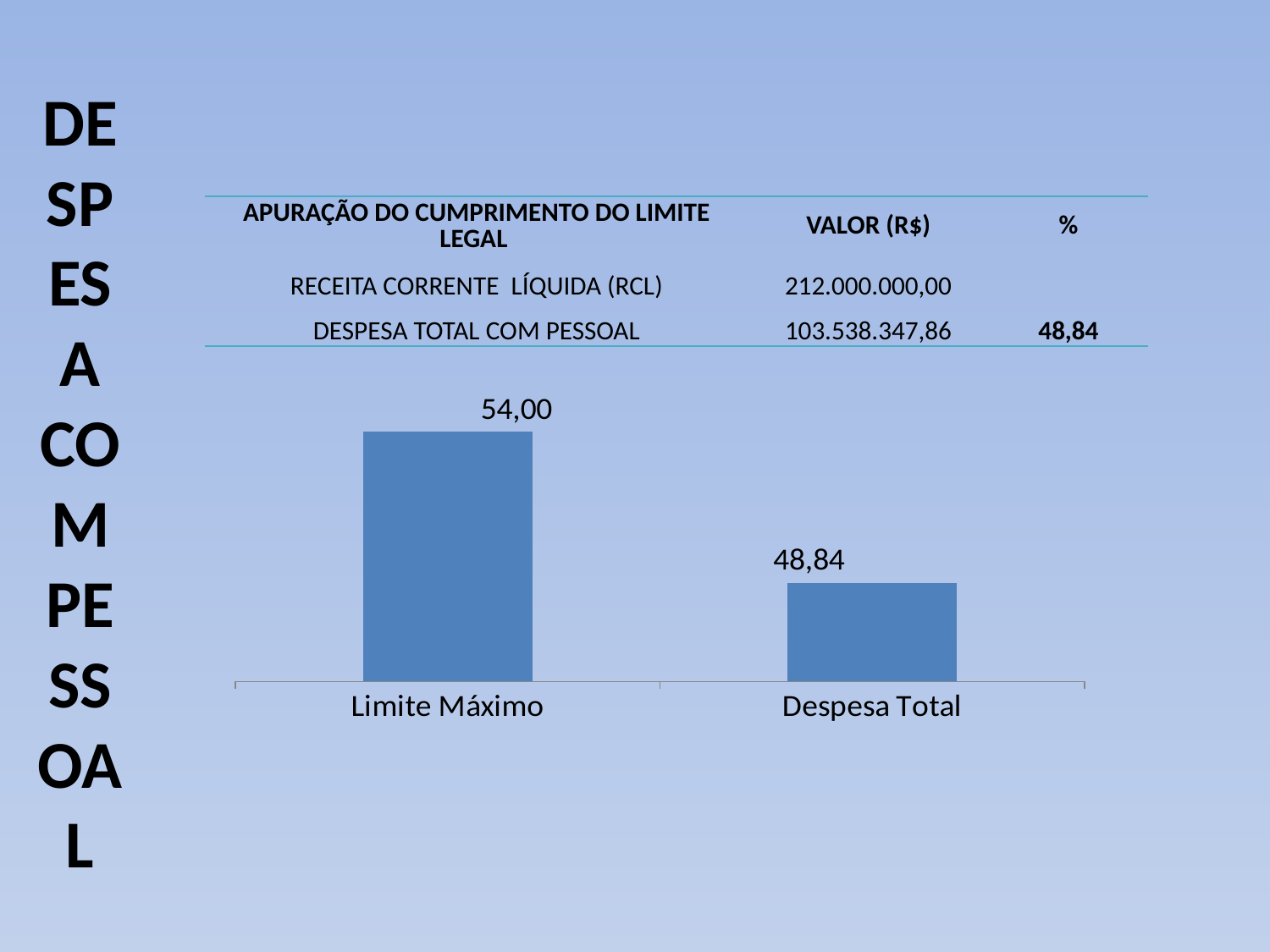
How many categories are plotted in the chart? 2 What is the difference between the values for Limite Máximo and Despesa Total? 5,16 Which category has the lowest value? Despesa Total Do the values rise or fall from left to right along the x axis? Fall What is the value shown for Despesa Total? 48,84 What is the value shown for Limite Máximo? 54,00 Which category has the highest value? Limite Máximo Which is larger, the value for Limite Máximo or the value for Despesa Total? Limite Máximo What is the label of the first category on the x axis? Limite Máximo What colour are the bars in the chart? Blue What kind of chart is shown on the slide? Bar chart